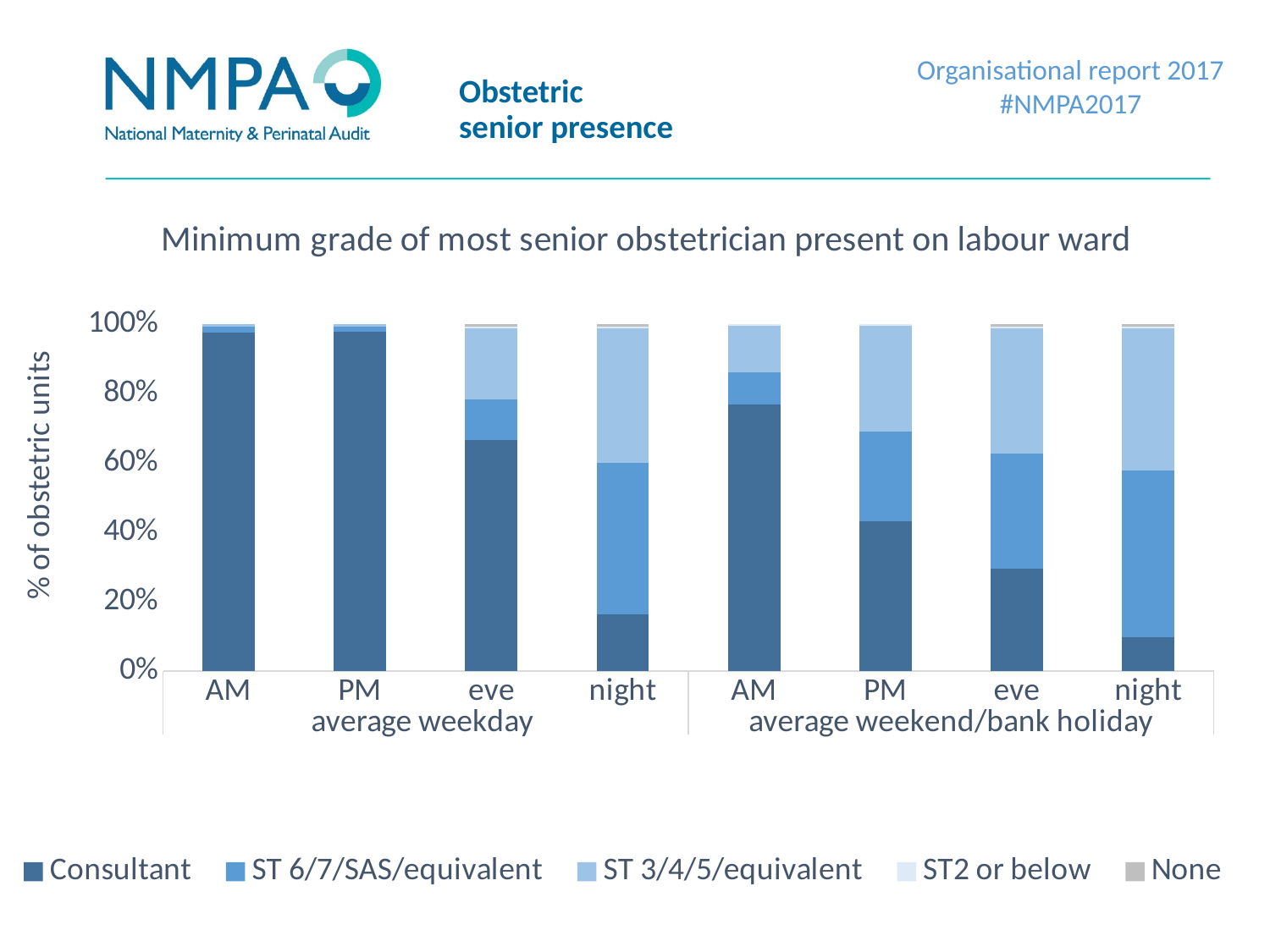
How many bars are plotted in the chart? 8 Is the Consultant share for the average weekday night bar greater or less than 20%? less Which has the larger Consultant share: the average weekday PM bar or the average weekend/bank holiday PM bar? average weekday PM Is the Consultant share for the average weekend/bank holiday AM bar greater or less than 60%? greater Is the Consultant share for the average weekend/bank holiday PM bar greater or less than 60%? less What is the title of the chart? Minimum grade of most senior obstetrician present on labour ward What kind of chart is shown on the slide? Stacked bar chart Within the average weekday group, does the Consultant share rise or fall from AM to night? fall Which has the larger Consultant share: the average weekday night bar or the average weekend/bank holiday night bar? average weekday night How many series does the legend list? 5 Which bar has the smallest Consultant share? average weekend/bank holiday night